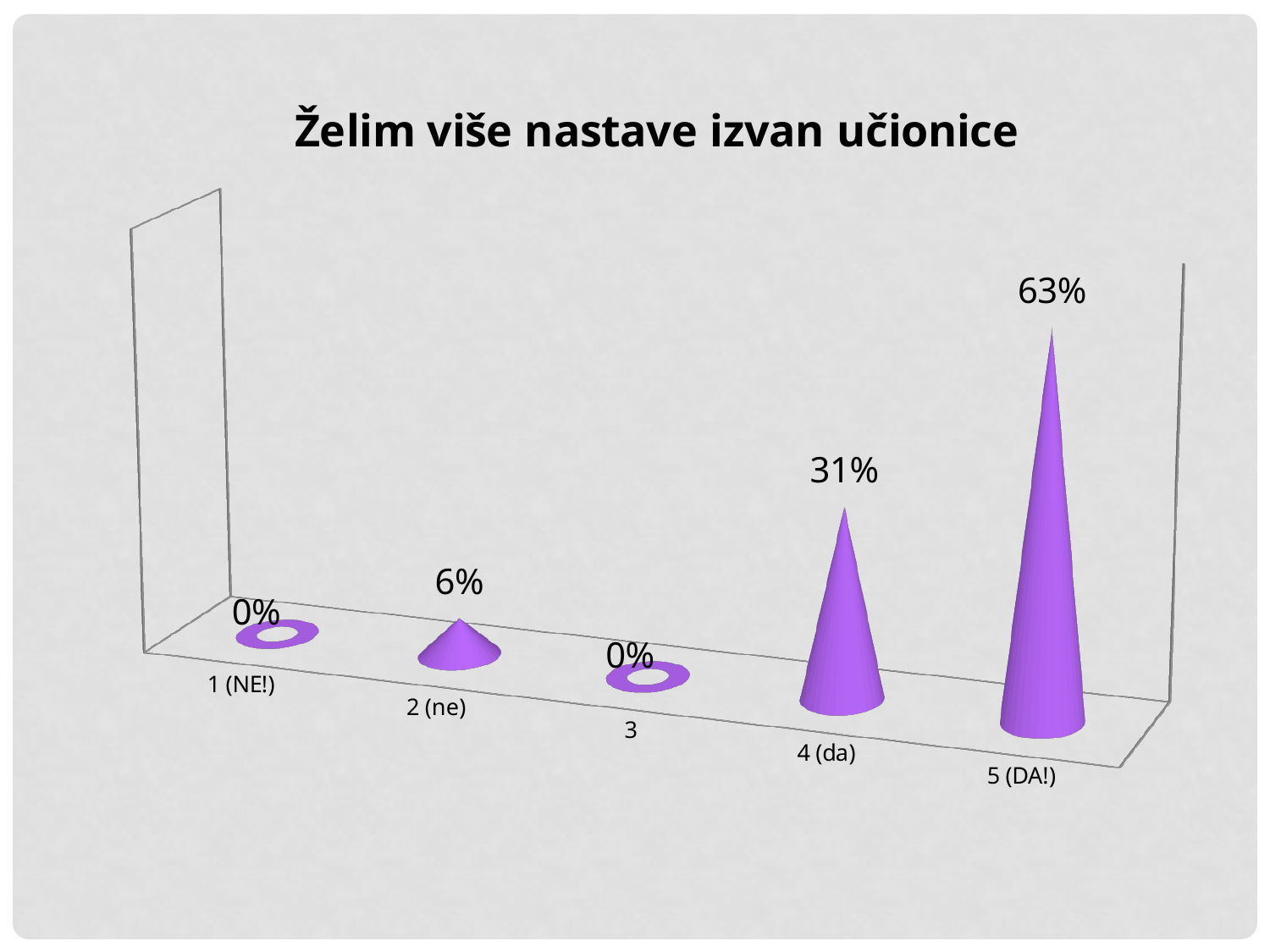
What is the title of the chart? Želim više nastave izvan učionice How many categories are shown on the x axis? 5 What is the value for 1 (NE!)? 0% What is the difference between the values for 4 (da) and 2 (ne)? 25% What is the value for 5 (DA!)? 63% Which category has the highest value? 5 (DA!) What is the value for category 3? 0% What kind of chart is shown on the slide? bar chart Which is larger, the value for 4 (da) or the value for 2 (ne)? 4 (da) What is the value for 2 (ne)? 6% What is the value for 4 (da)? 31% What is the difference between the values for 5 (DA!) and 4 (da)? 32%